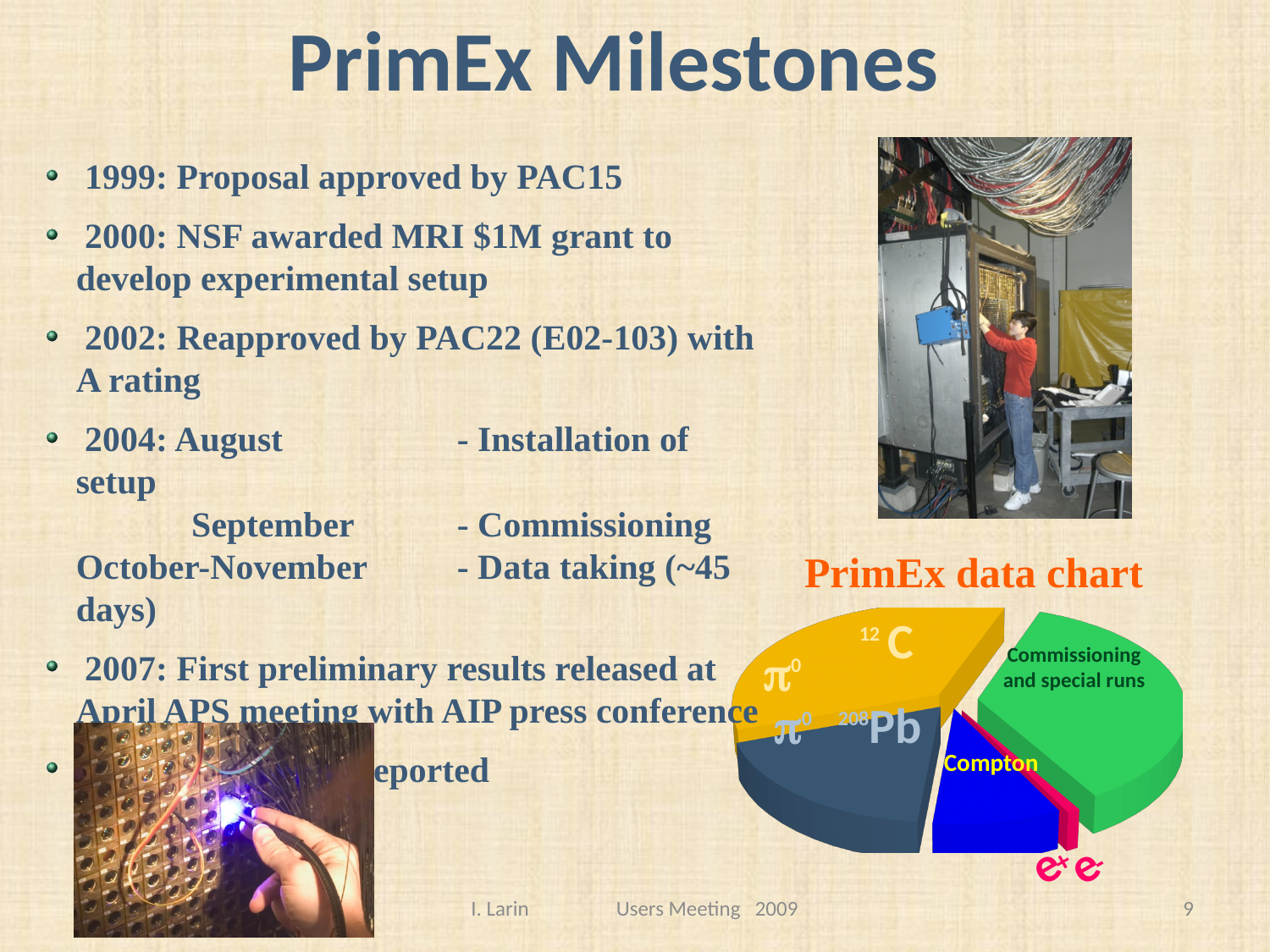
How many slices does the "PrimEx data chart" pie have? 5 What is the title of the chart on the slide? PrimEx data chart In the "PrimEx data chart", which slice is the smallest? e⁺e⁻ In the "PrimEx data chart", which slice is larger: π⁰ ¹²C or Compton? π⁰ ¹²C What kind of chart is the "PrimEx data chart"? pie chart In the "PrimEx data chart", which slice is larger: Commissioning and special runs or Compton? Commissioning and special runs What colour is the "Commissioning and special runs" slice in the "PrimEx data chart"? green In the "PrimEx data chart", which slice is larger: Compton or e⁺e⁻? Compton